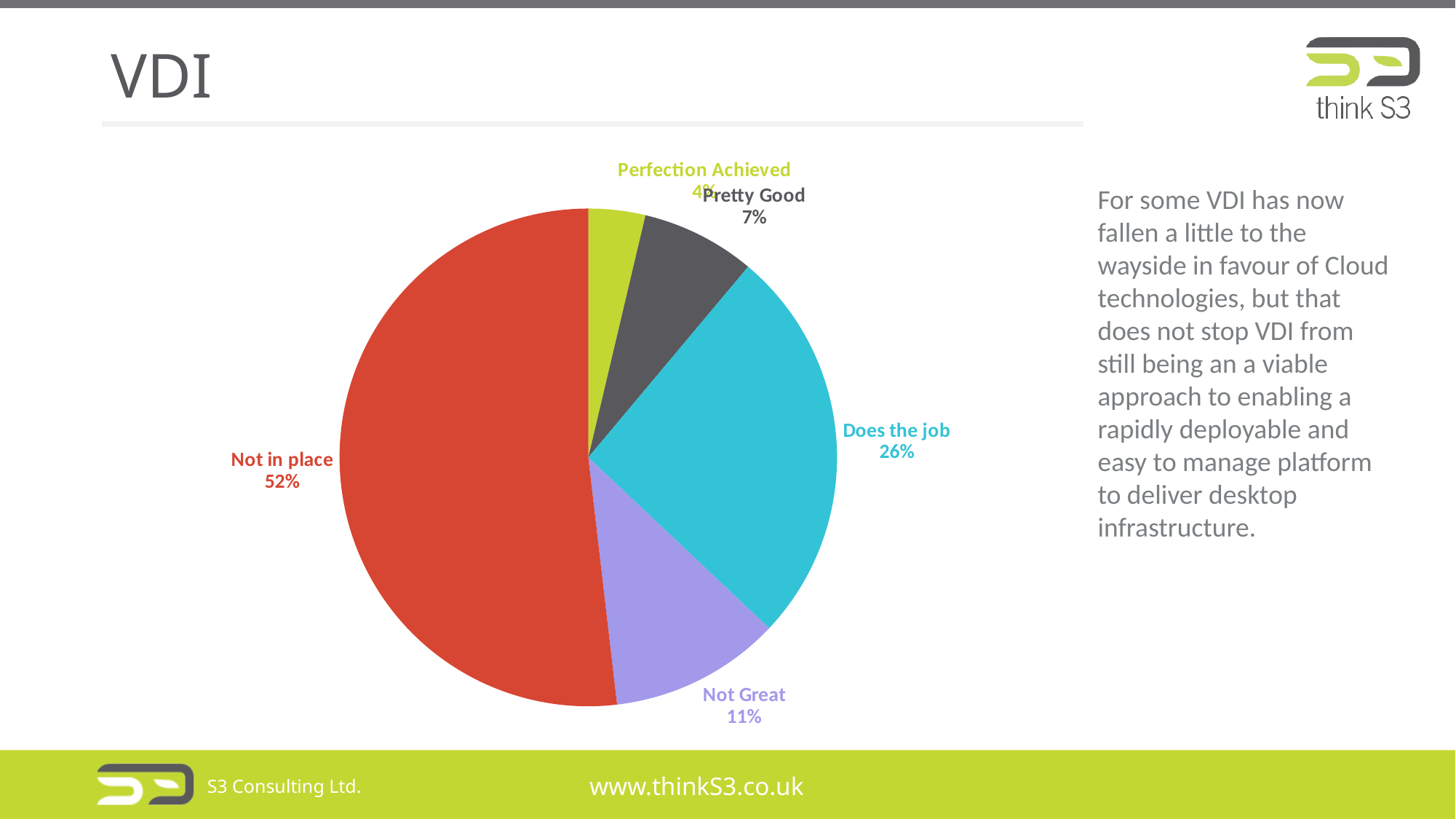
What percentage of the pie is 'Not Great'? 11% Which is larger, 'Not Great' or 'Pretty Good'? Not Great What colour is the 'Does the job' slice? cyan What percentage of the pie is 'Perfection Achieved'? 4% What percentage of the pie is 'Pretty Good'? 7% What percentage of the pie is 'Not in place'? 52% What percentage of the pie is 'Does the job'? 26% What is the difference in percentage points between 'Not in place' and 'Does the job'? 26 Which slice of the pie is the largest? Not in place Which slice of the pie is the smallest? Perfection Achieved What kind of chart is shown on the slide? pie chart How many slices does the pie chart have? 5